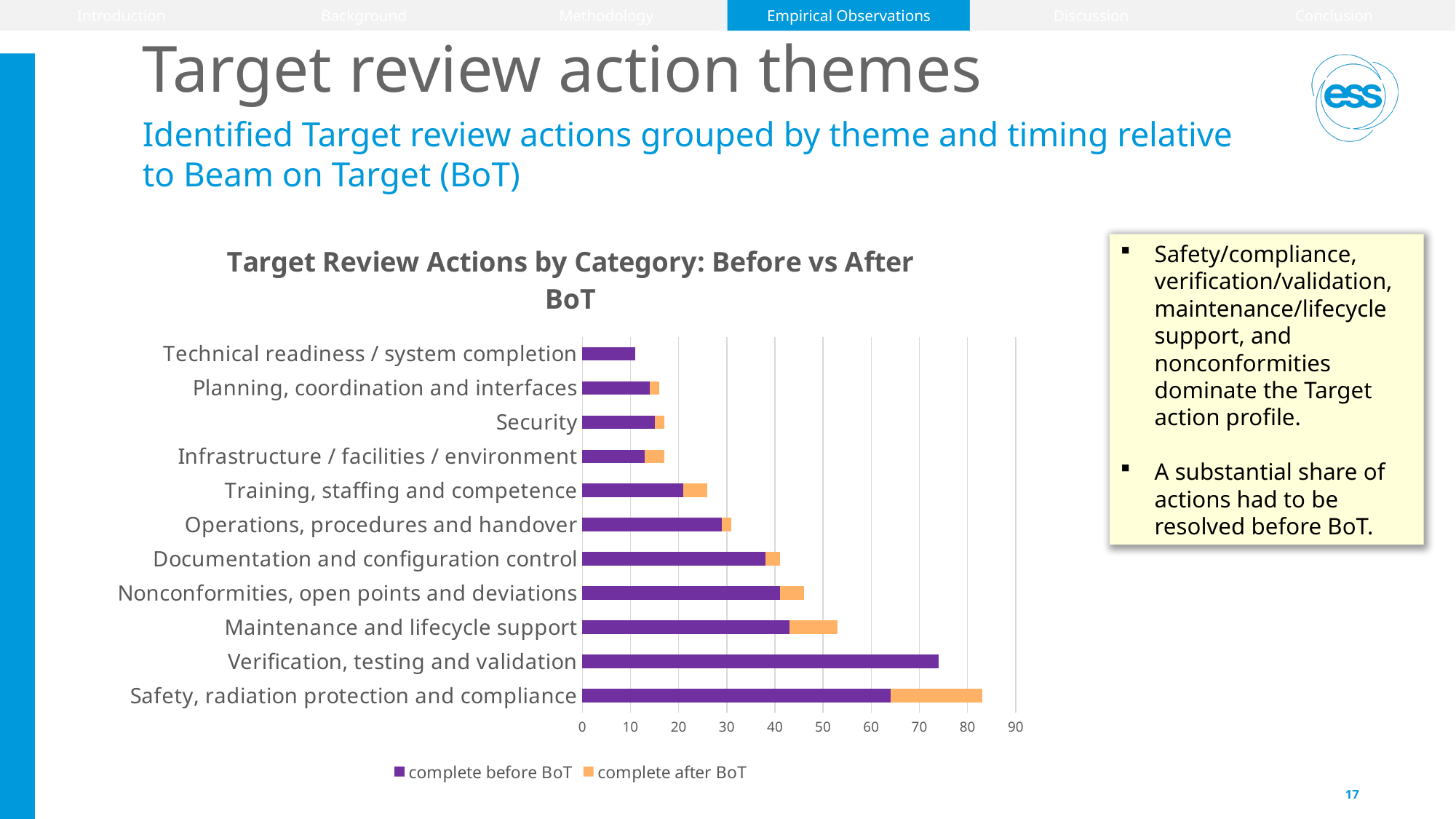
Which has the longer total bar: Documentation and configuration control or Operations, procedures and handover? Documentation and configuration control Which category has the largest 'complete after BoT' segment? Safety, radiation protection and compliance Which category has the longest total bar in the chart? Safety, radiation protection and compliance Is the total bar for Training, staffing and competence greater or less than 30? less Which category has the largest 'complete before BoT' segment? Verification, testing and validation What is the title of the chart? Target Review Actions by Category: Before vs After BoT What kind of chart is shown on the slide? bar chart How many series does the chart legend list? 2 Is the 'complete before BoT' value for Verification, testing and validation greater or less than 70? greater How many categories are plotted in the chart? 11 Which category has the shortest total bar in the chart? Technical readiness / system completion Is the total bar for Safety, radiation protection and compliance greater or less than 80? greater